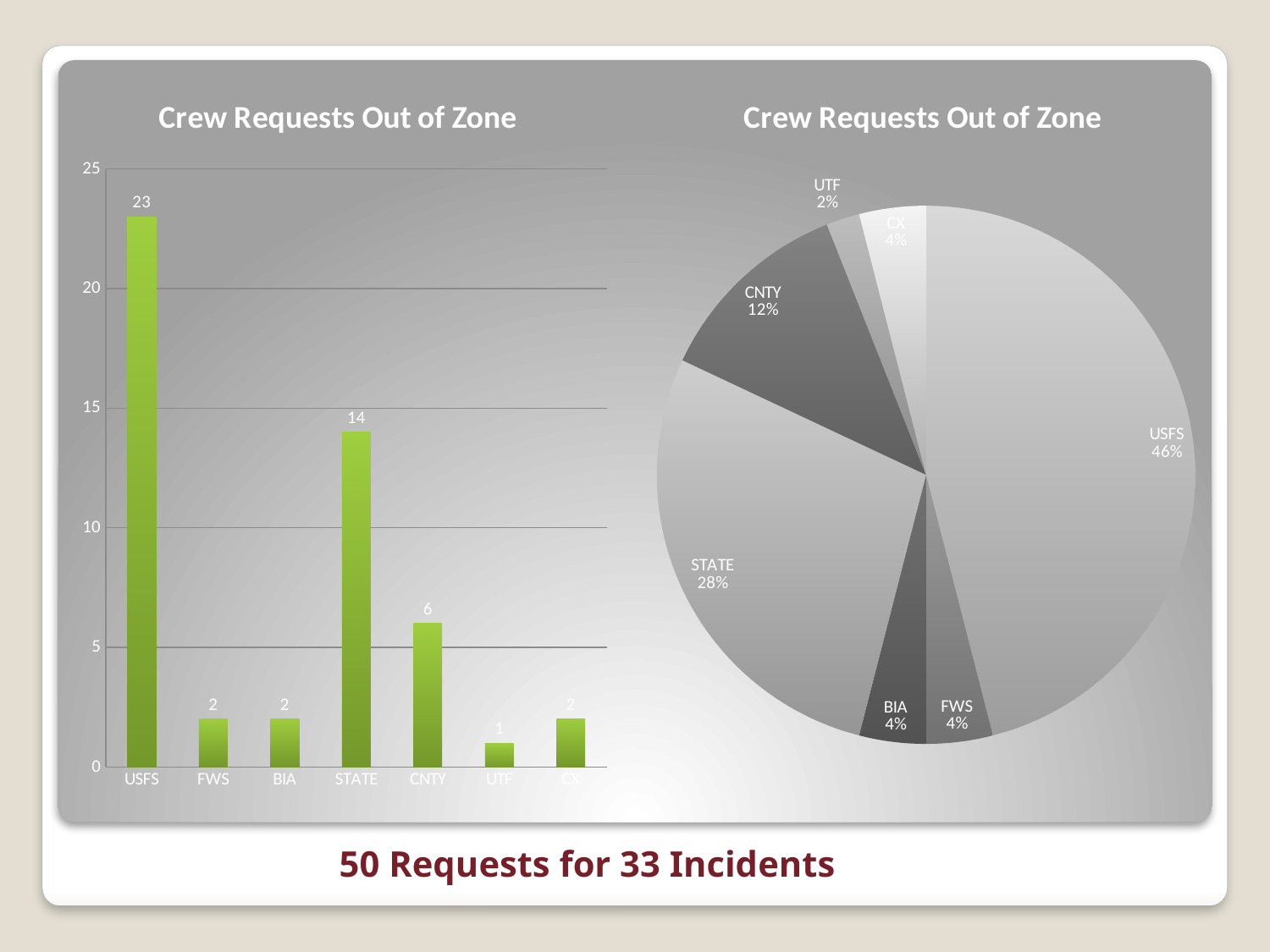
In the pie chart on the right, which slice is the smallest? UTF In the pie chart on the right, what share does CNTY have? 12% In the bar chart on the left, what is the value for CNTY? 6 How many categories are shown in the bar chart on the left? 7 In the bar chart on the left, what is the value for USFS? 23 In the bar chart on the left, which category has the lowest value? UTF In the bar chart on the left, which category has the highest value? USFS What kind of chart is on the left side of the slide? Bar chart In the bar chart on the left, which is larger, the value for CNTY or the value for BIA? CNTY In the pie chart on the right, what share does USFS have? 46% In the bar chart on the left, what is the difference between the values for USFS and STATE? 9 In the bar chart on the left, what is the value for STATE? 14